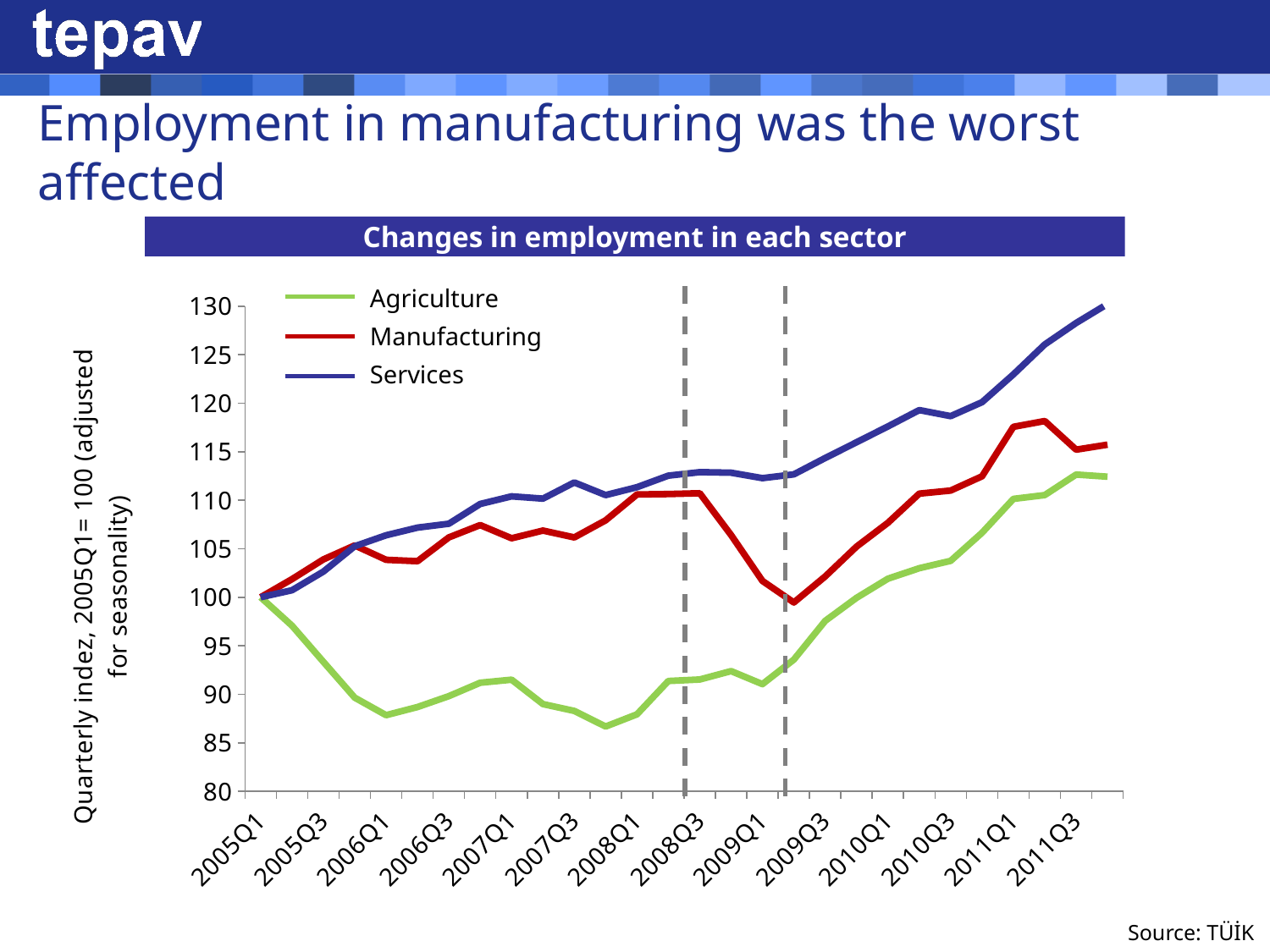
What is the index value of every series at 2005Q1? 100 What is the title of the chart? Changes in employment in each sector What kind of chart is shown on the slide? line chart Which series has the highest value at 2011Q3? Services How many series does the legend list? 3 Which series has the lowest value at 2008Q1? Agriculture At 2007Q1, which is higher: Agriculture or Manufacturing? Manufacturing Is the value for Services at 2011Q3 greater or less than 125? greater Does the Agriculture line rise or fall between 2005Q1 and 2006Q1? fall Which colour is used for the Manufacturing line? red Is the value for Agriculture at 2008Q1 greater or less than 90? less Is the value for Manufacturing at 2009Q2 greater or less than 105? less